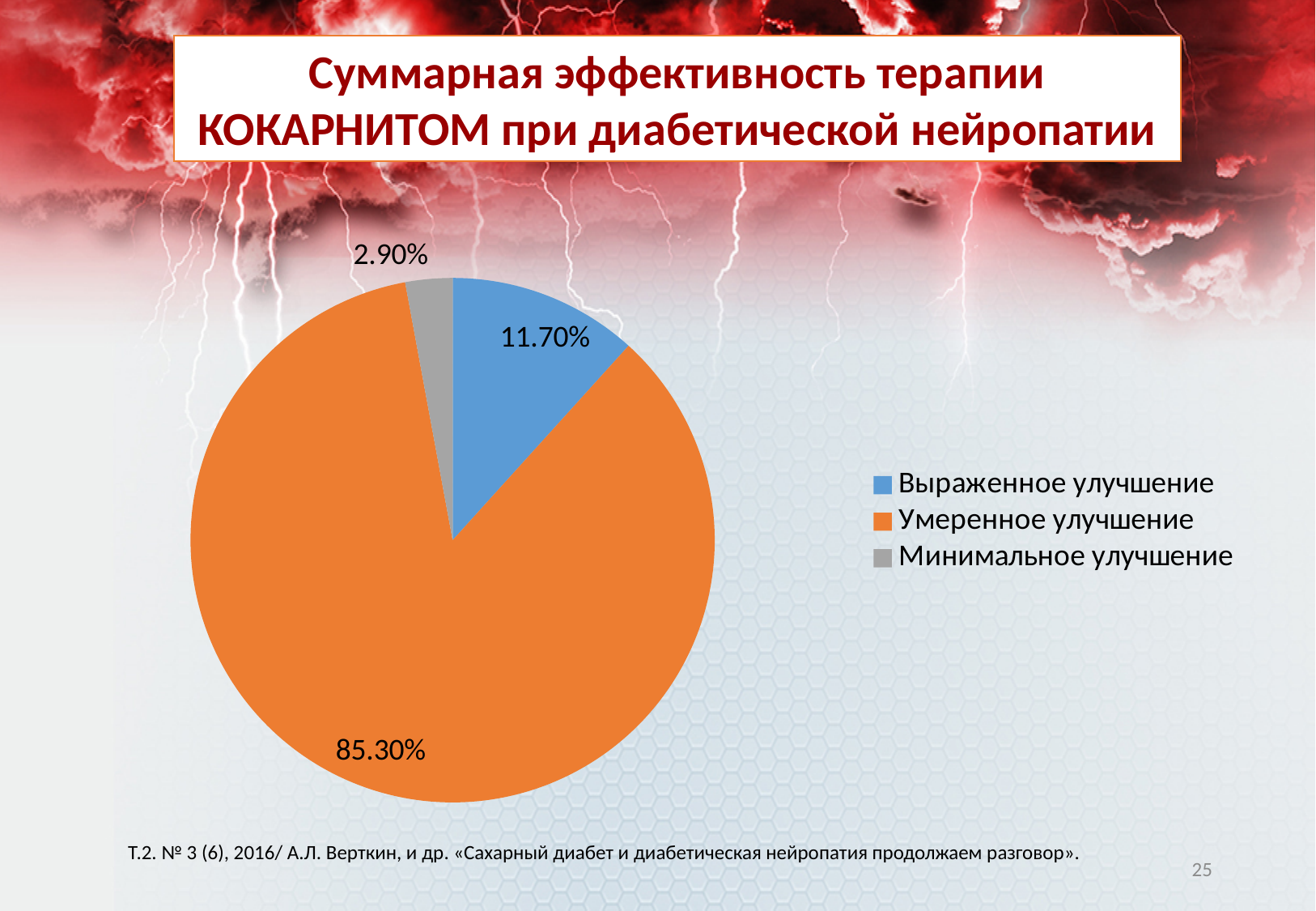
What is the difference between the values for "Умеренное улучшение" and "Выраженное улучшение"? 73.60% Which category has the largest slice of the pie? Умеренное улучшение What is the value for "Выраженное улучшение"? 11.70% Which category has the smallest slice of the pie? Минимальное улучшение What kind of chart is shown on the slide? Pie chart How many categories does the pie chart have? 3 What share of the pie does "Умеренное улучшение" represent? 85.30% What is the difference between the values for "Выраженное улучшение" and "Минимальное улучшение"? 8.80% What colour is the slice for "Умеренное улучшение"? Orange Which is larger, the value for "Выраженное улучшение" or the value for "Минимальное улучшение"? Выраженное улучшение How many entries does the legend list? 3 What is the value for "Минимальное улучшение"? 2.90%